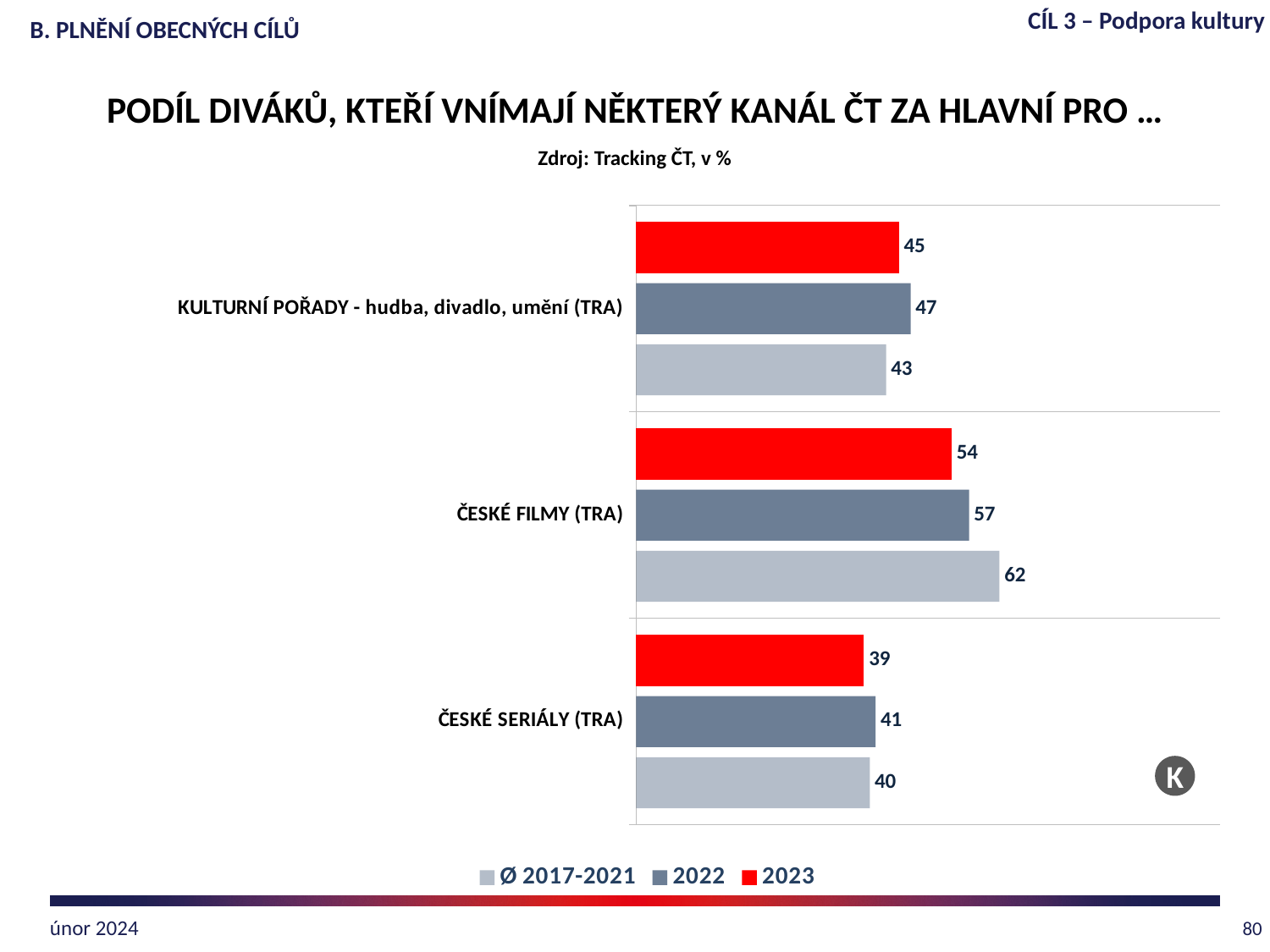
Which category has the highest 2023 value? ČESKÉ FILMY (TRA) What is the 2023 value for ČESKÉ FILMY (TRA)? 54 How many categories are shown on the chart? 3 Which is larger for ČESKÉ SERIÁLY (TRA): the 2022 value or the 2023 value? 2022 Which series is shown in red in the legend? 2023 What is the 2022 value for ČESKÉ SERIÁLY (TRA)? 41 How many series does the legend list? 3 What is the difference between the Ø 2017-2021 value and the 2023 value for ČESKÉ FILMY (TRA)? 8 What is the Ø 2017-2021 value for KULTURNÍ POŘADY - hudba, divadlo, umění (TRA)? 43 Which category has the lowest Ø 2017-2021 value? ČESKÉ SERIÁLY (TRA) What is the difference between the 2022 and 2023 values for KULTURNÍ POŘADY - hudba, divadlo, umění (TRA)? 2 What kind of chart is shown on the slide? Bar chart